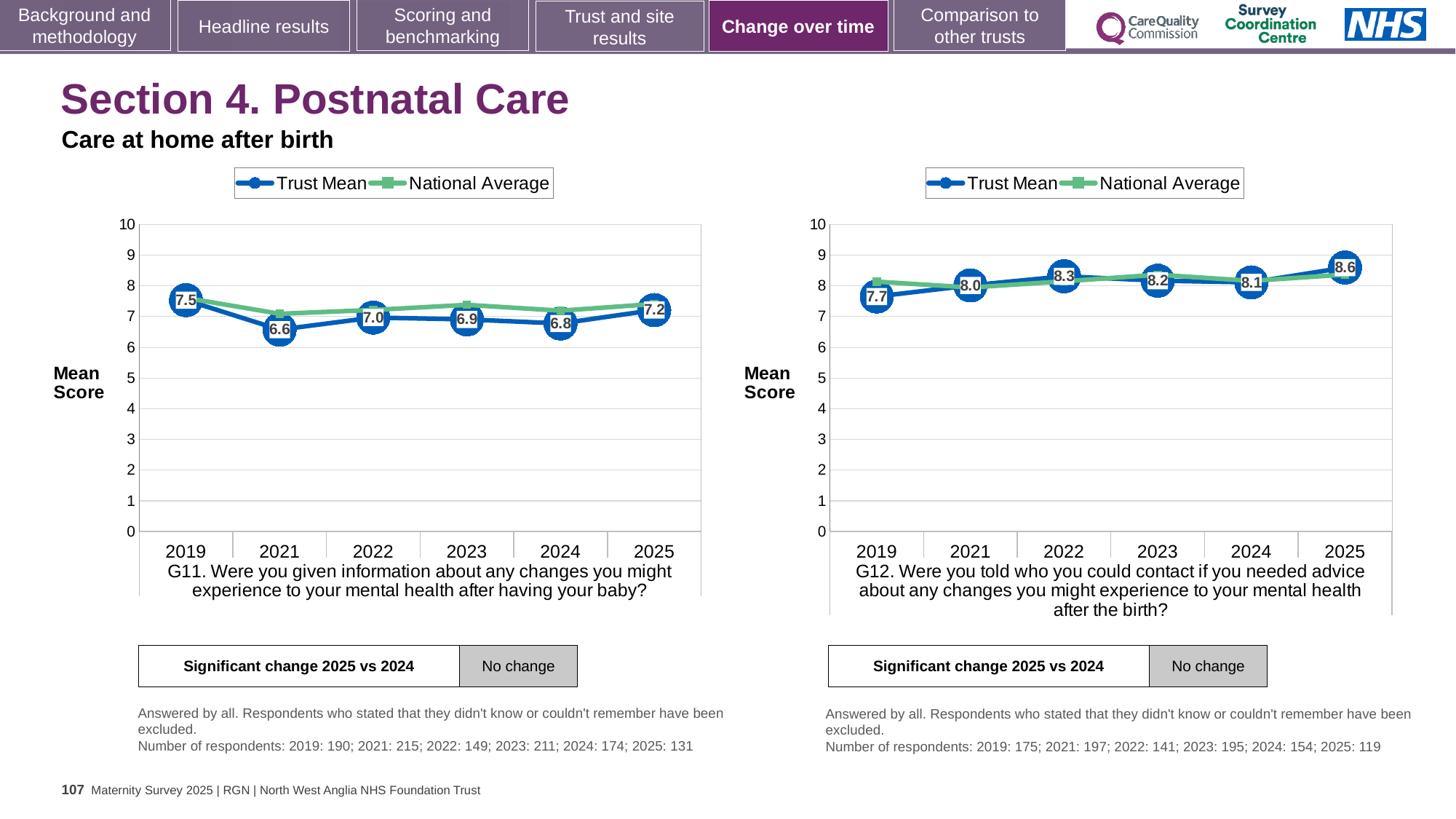
What type of chart is the G12 chart on the right? Line chart How many years are plotted on the x axis of the G12 chart on the right? 6 How many series does the legend of the G11 chart on the left list? 2 In the G11 chart on the left, what is the difference between the Trust Mean scores for 2019 and 2021? 0.9 In the G12 chart on the right, which year has the highest Trust Mean score? 2025 In the G11 chart on the left, what is the Trust Mean score for 2025? 7.2 In the G12 chart on the right, what is the difference between the Trust Mean scores for 2025 and 2024? 0.5 In the G11 chart on the left, is the Trust Mean score for 2024 greater or less than 7? less In the G12 chart on the right, is the Trust Mean score for 2019 higher or lower than for 2021? lower In the G11 chart on the left, what is the Trust Mean score for 2019? 7.5 In the G12 chart on the right, what is the Trust Mean score for 2022? 8.3 In the G11 chart on the left, which year has the lowest Trust Mean score? 2021